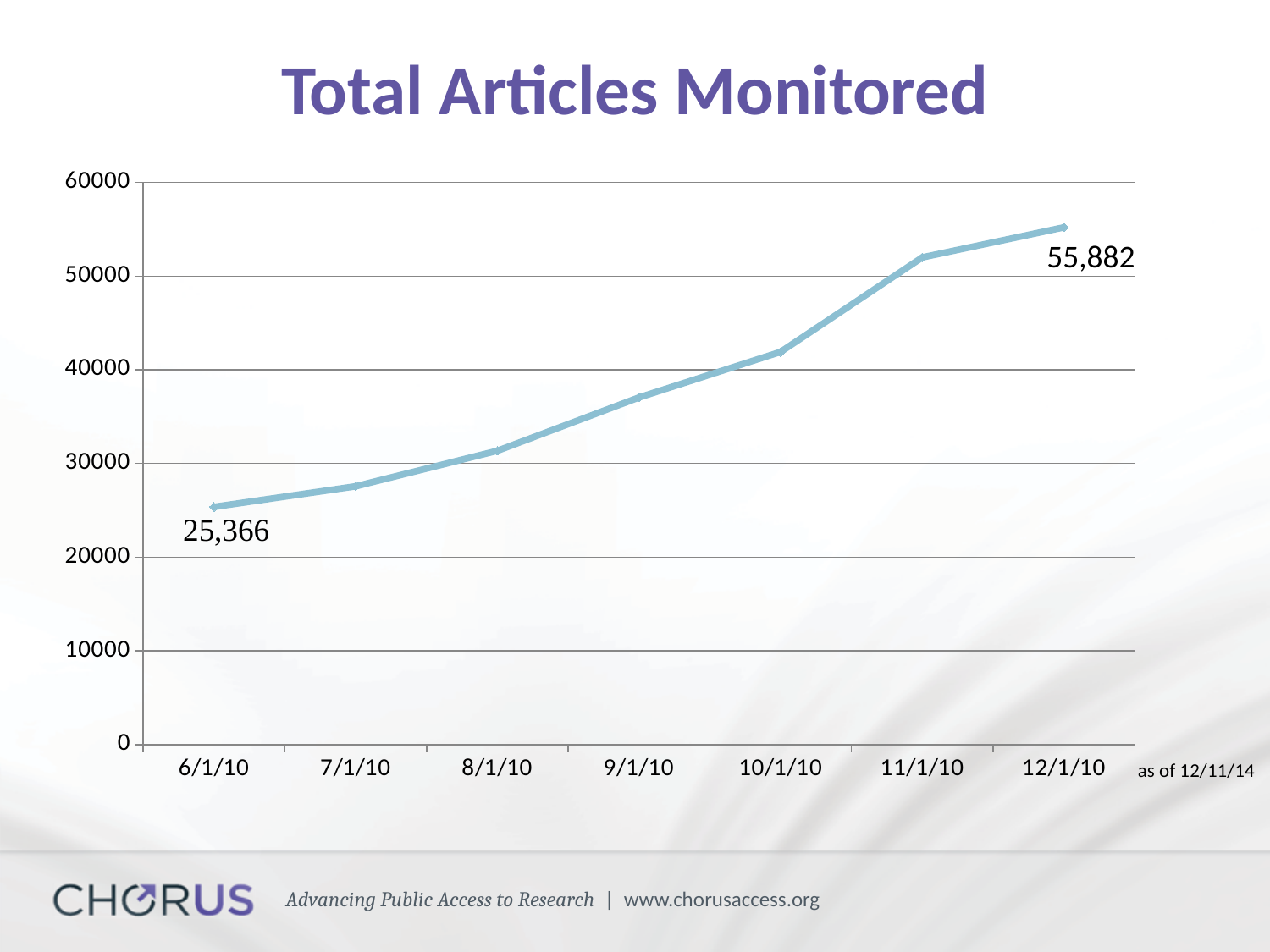
What type of chart is shown on the slide? line chart Is the value for 10/1/10 greater or less than 40000? greater What is the value for 12/1/10? 55,882 Which date has the highest value? 12/1/10 Do the values rise or fall from 6/1/10 to 12/1/10? rise Is the value for 11/1/10 greater or less than 50000? greater Which date has the lowest value? 6/1/10 What is the value for 6/1/10? 25,366 What is the difference between the value for 12/1/10 and the value for 6/1/10? 30,516 How many data points are plotted on the line? 7 Is the value for 7/1/10 greater or less than 30000? less What is the title of the chart? Total Articles Monitored